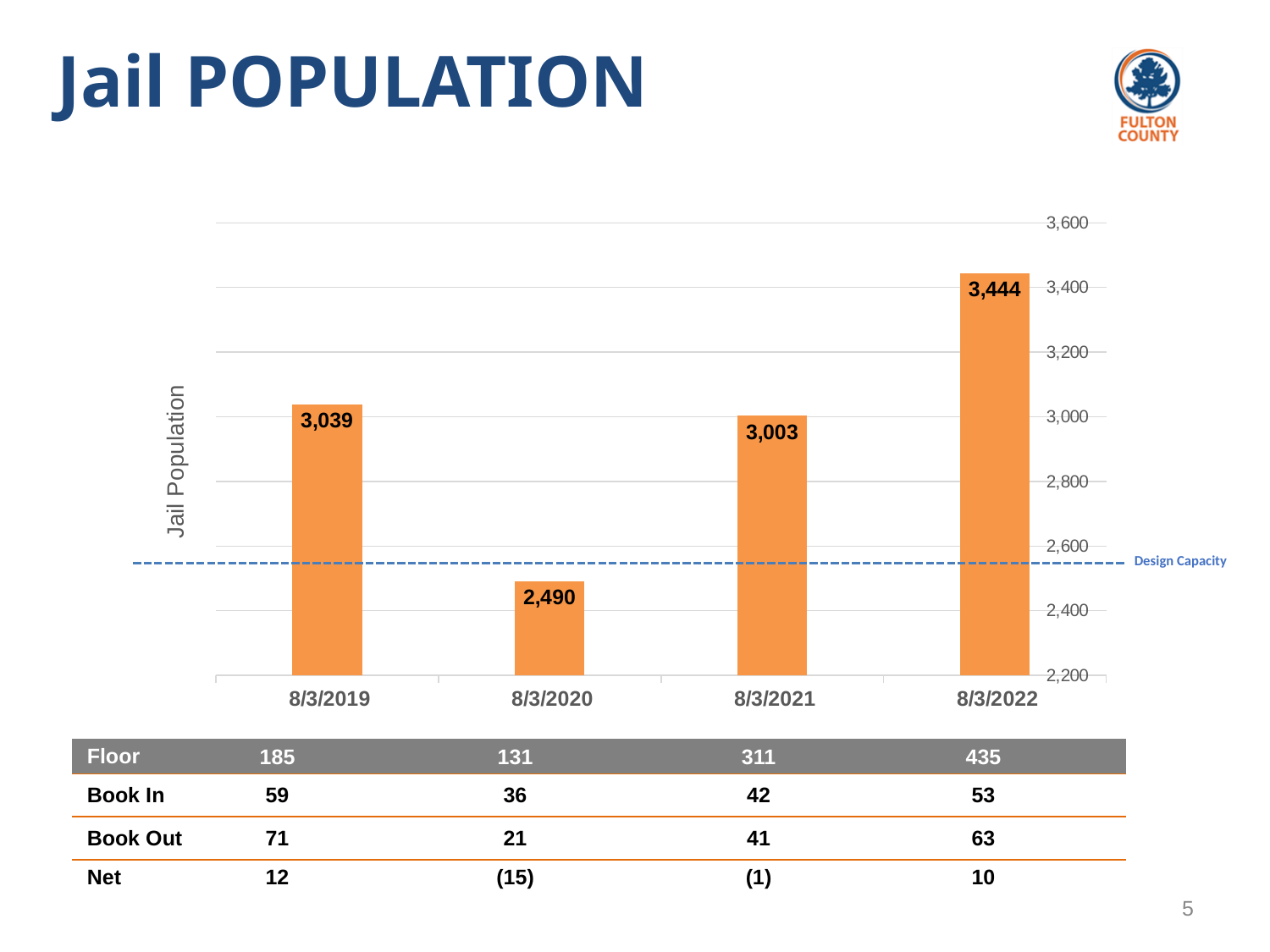
What is the jail population on 8/3/2021? 3,003 What is the jail population on 8/3/2020? 2,490 Which date has the lowest jail population? 8/3/2020 How many dates are shown on the x axis of the chart? 4 Which date has the highest jail population? 8/3/2022 Which is larger, the jail population on 8/3/2019 or on 8/3/2021? 8/3/2019 Is the jail population on 8/3/2020 greater or less than 2,600? less What is the jail population on 8/3/2022? 3,444 What is the jail population on 8/3/2019? 3,039 What is the difference in jail population between 8/3/2022 and 8/3/2019? 405 What kind of chart is shown on the slide? bar chart What is the difference in jail population between 8/3/2021 and 8/3/2020? 513